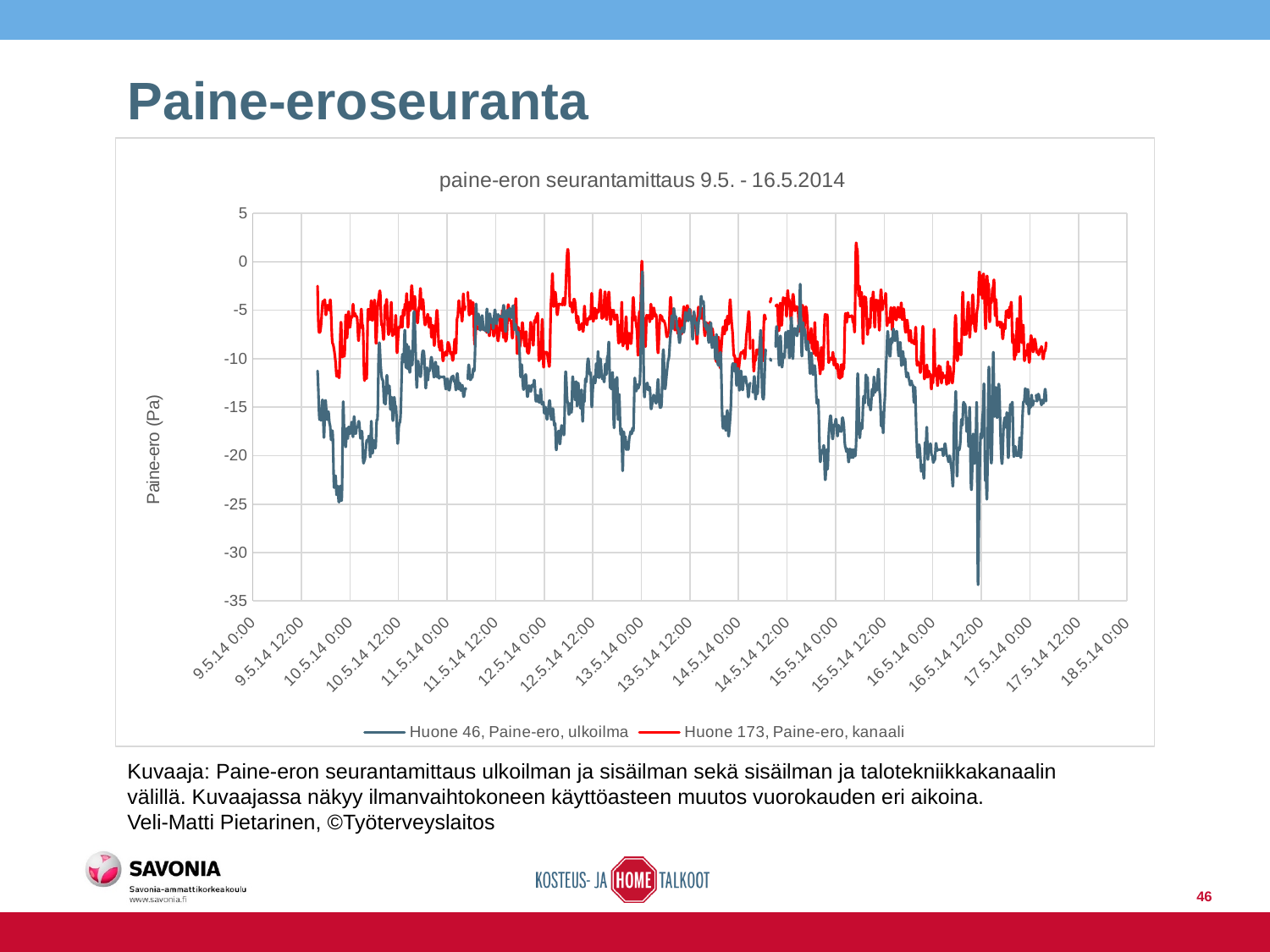
What is the highest tick value shown on the vertical axis? 5 What are the two series named in the legend? Huone 46, Paine-ero, ulkoilma and Huone 173, Paine-ero, kanaali Which series reaches the lowest value on the chart? Huone 46, Paine-ero, ulkoilma How many series does the legend list? 2 What is the label on the vertical axis? Paine-ero (Pa) Is the highest value reached by Huone 173, Paine-ero, kanaali greater or less than 0? greater Is the value for Huone 46, Paine-ero, ulkoilma at 10.5.14 0:00 greater or less than -15? less Is the lowest value reached by Huone 46, Paine-ero, ulkoilma greater or less than -30? less What is the lowest tick value shown on the vertical axis? -35 What kind of chart is shown on the slide? line chart Which series generally has the higher (closer to zero) values across the whole period? Huone 173, Paine-ero, kanaali